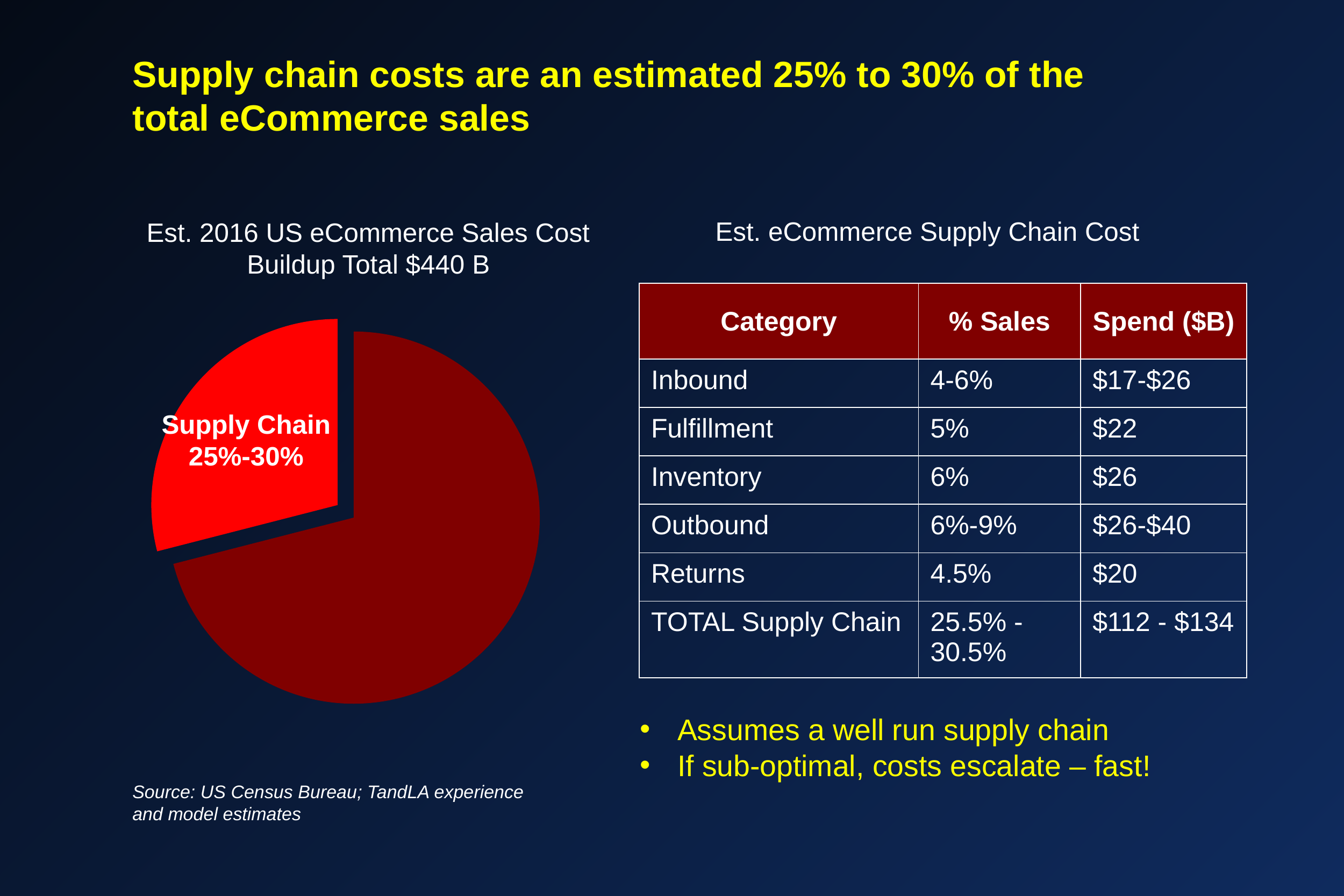
What share of the pie chart is labelled for Supply Chain? 25%-30% How many slices does the pie chart have? 2 What is the data label on the highlighted slice of the pie chart? Supply Chain 25%-30% In the pie chart, is the Supply Chain slice larger or smaller than the remaining slice? smaller What kind of chart is shown on the left of the slide? pie chart Which slice of the pie chart is pulled out from the rest of the pie? Supply Chain Is the Supply Chain slice of the pie chart greater or less than 50% of the pie? less What total value is stated in the pie chart's title? $440 B Which slice of the pie chart is the smallest? Supply Chain